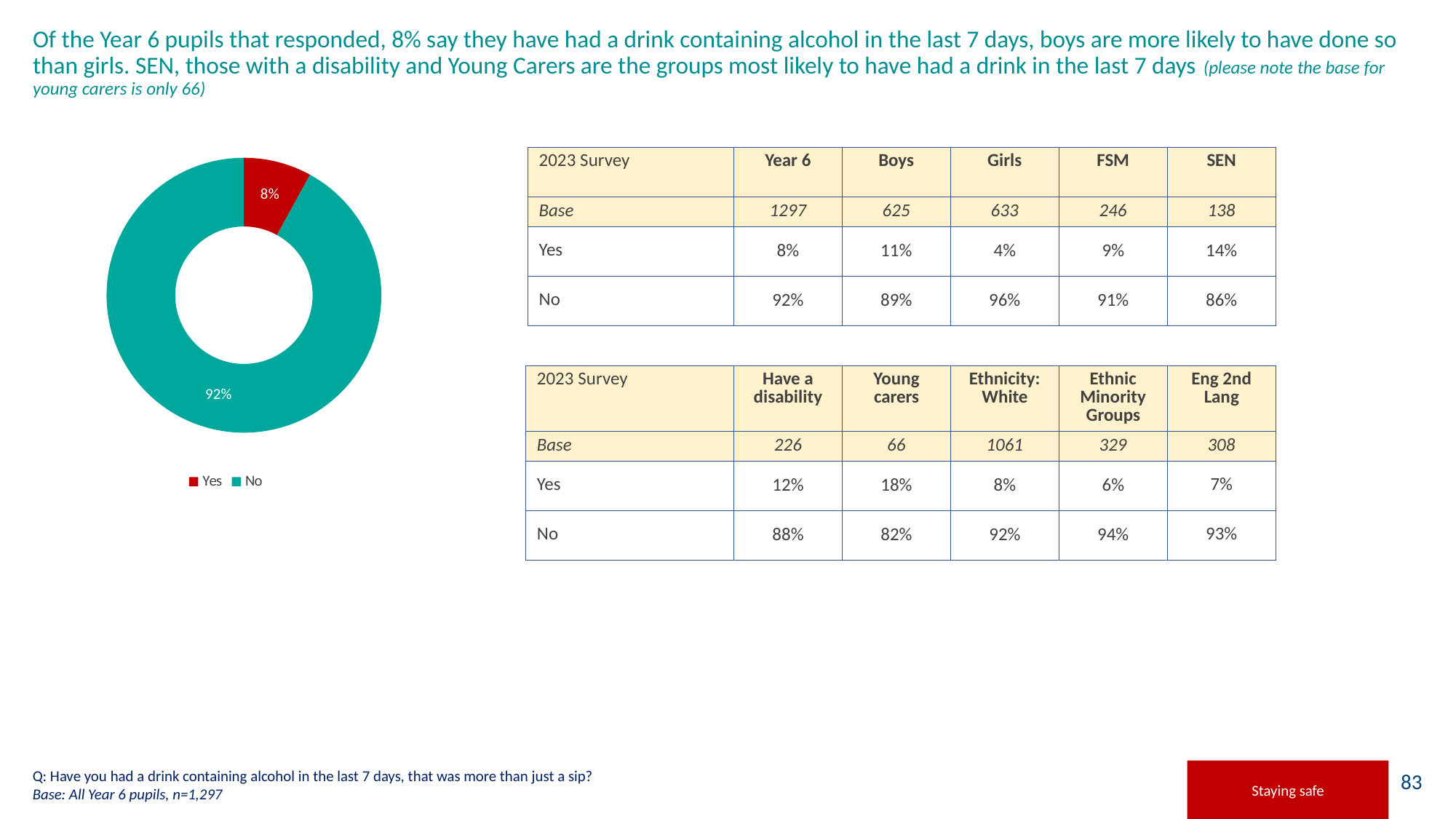
Which slice of the donut chart is the smallest? Yes Which slice of the donut chart is the largest? No What type of chart is shown on the left of the slide? Donut (pie) chart What colour is the "No" slice in the donut chart? Teal In the donut chart, is the "Yes" slice larger or smaller than the "No" slice? smaller What percentage of the donut chart is labelled "No"? 92% What is the difference in percentage points between the "No" and "Yes" slices of the donut chart? 84 What percentage of the donut chart is labelled "Yes"? 8% What share of the donut chart does the "No" slice represent? 92% How many slices does the donut chart have? 2 How many entries does the legend of the donut chart list? 2 What colour is the "Yes" slice in the donut chart? Red